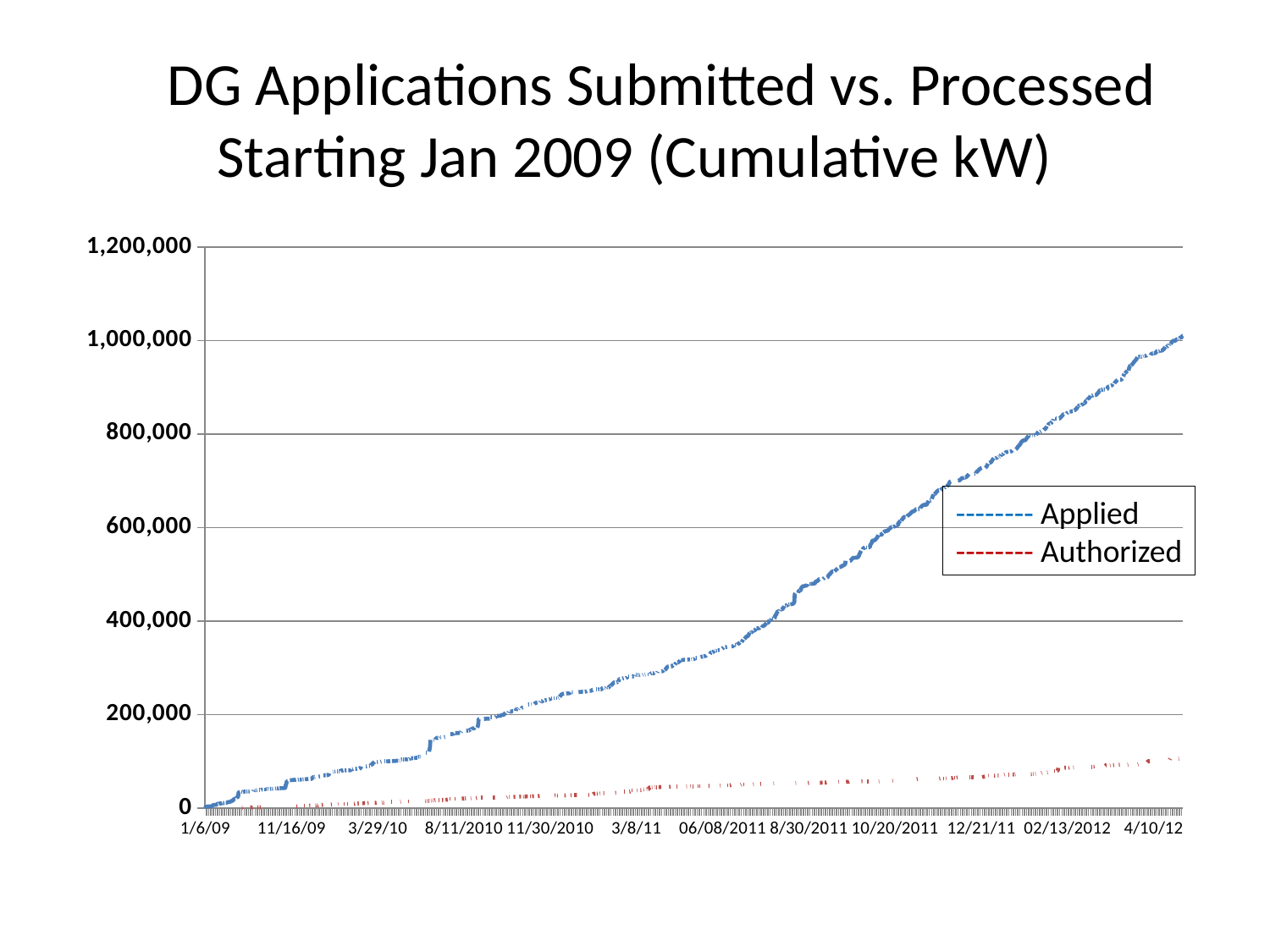
Is the value for Applied at 8/30/2011 greater or less than 400,000? greater Is the value for Applied at 12/21/11 greater or less than 800,000? less Is the value for Authorized at 4/10/12 greater or less than 200,000? less What are the two series named in the legend? Applied and Authorized How many series does the legend list? 2 Which series is higher at 4/10/12, Applied or Authorized? Applied What is the title of the chart? DG Applications Submitted vs. Processed Starting Jan 2009 (Cumulative kW) Does the Authorized series rise or fall over time along the x axis? rise What kind of chart is shown on the slide? line chart Which series is higher at 8/30/2011, Applied or Authorized? Applied Does the Applied series rise or fall over time along the x axis? rise